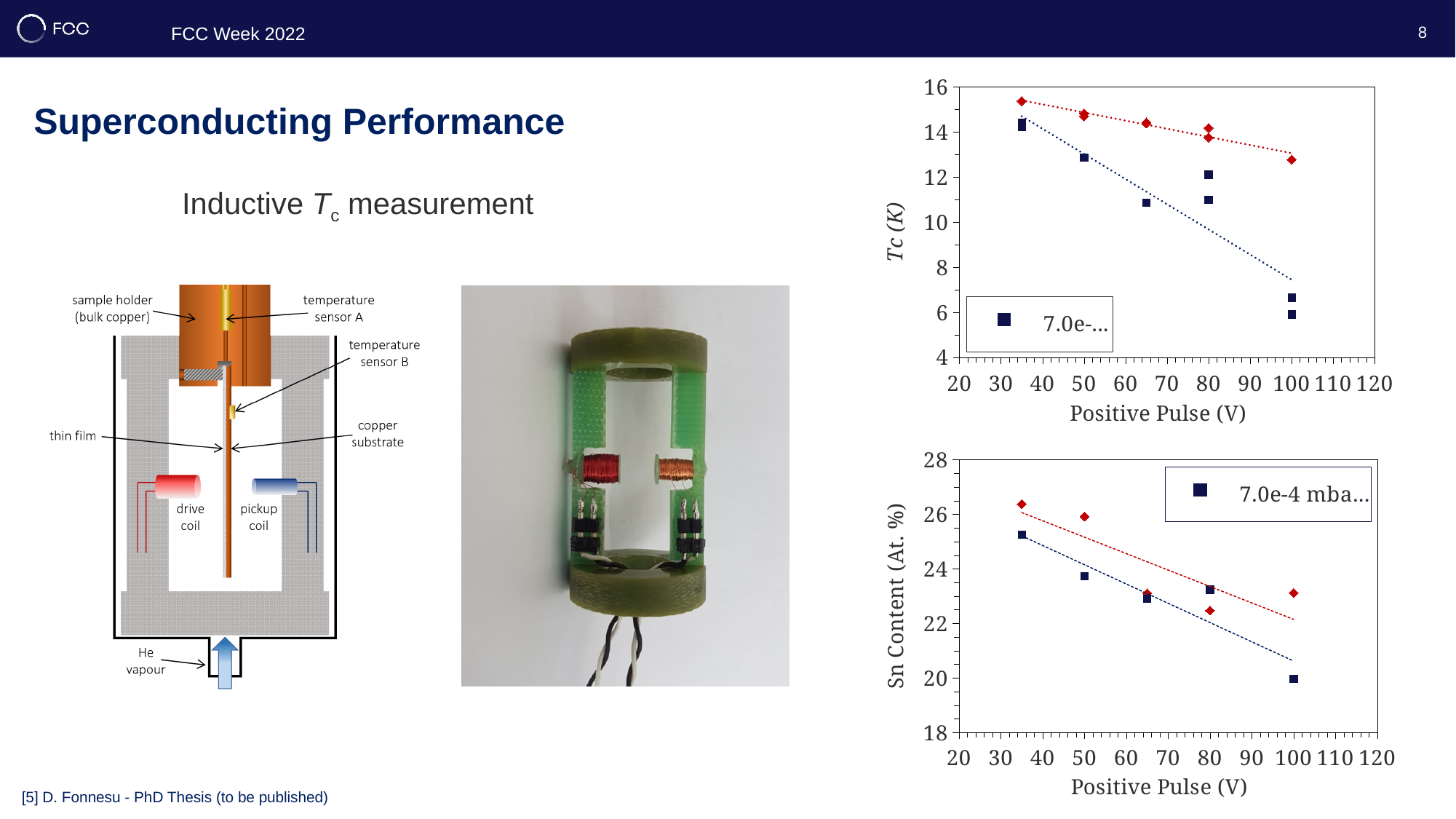
In the top chart on the right, is the red diamond value at 35 V greater or less than 14? greater In the top chart on the right, do the blue square values rise or fall as Positive Pulse increases? fall In the bottom chart on the right, at 35 V, which series has the higher Sn content: the red diamonds or the blue squares? red diamonds In the top chart on the right, is the blue square value at 35 V greater or less than 12? greater What kind of chart is the top chart on the right (Tc vs Positive Pulse)? scatter chart In the bottom chart on the right, do the blue square values rise or fall as Positive Pulse increases? fall In the bottom chart on the right, is the red diamond value at 35 V greater or less than 24? greater In the top chart on the right, at 100 V, which series has the higher Tc: the red diamonds or the blue squares? red diamonds In the top chart on the right, what is the label of the vertical axis? Tc (K) In the bottom chart on the right, what is the label of the vertical axis? Sn Content (At. %)